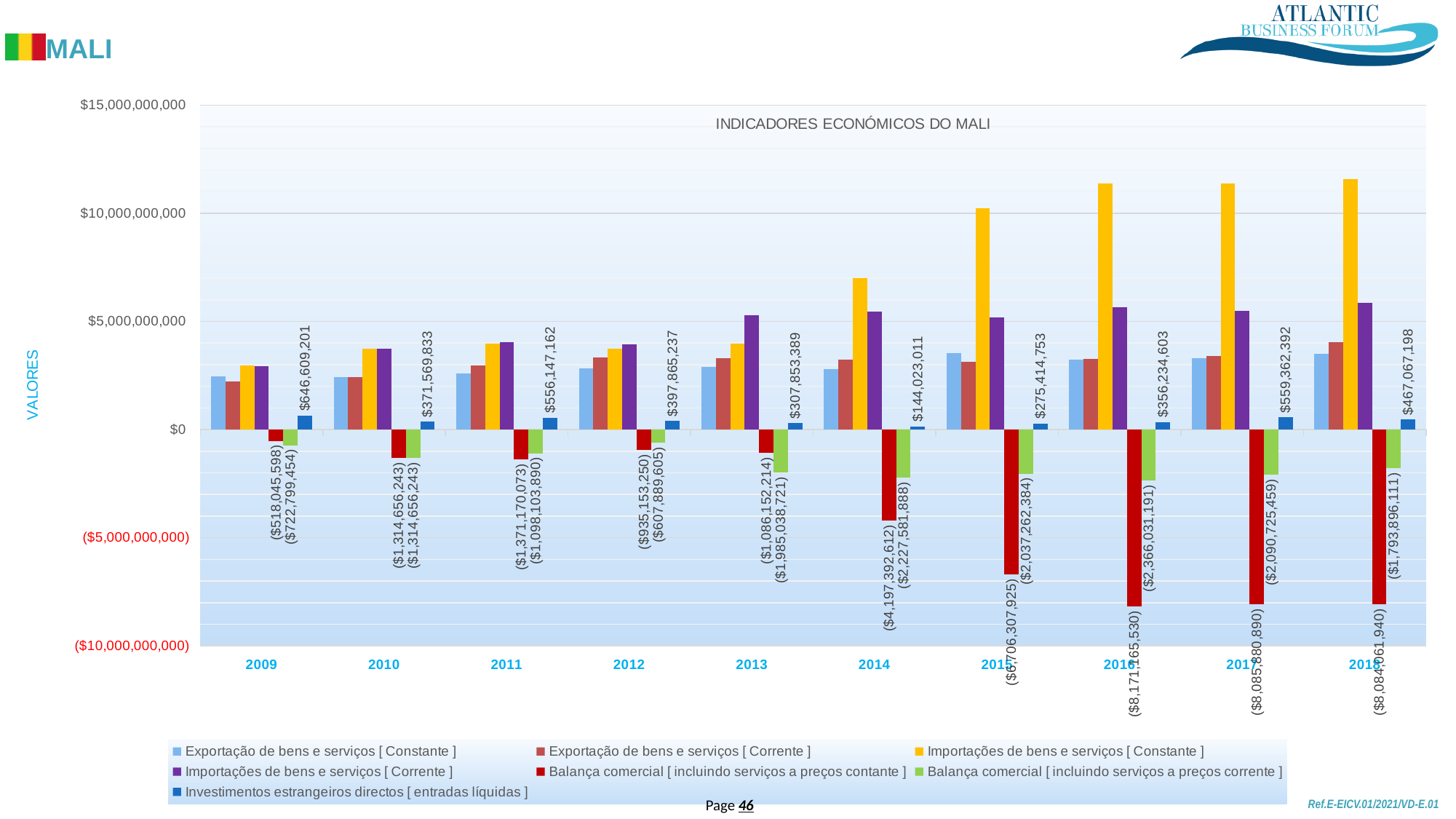
What is the value of Balança comercial [ incluindo serviços a preços corrente ] in 2013? ($1,985,038,721) In which year is Investimentos estrangeiros directos [ entradas líquidas ] lowest? 2014 Which year has the larger value for Importações de bens e serviços [ Constante ], 2013 or 2014? 2014 How many series does the legend list? 7 What is the title of the chart? INDICADORES ECONÓMICOS DO MALI What kind of chart is shown on the slide? bar chart How many years are shown on the x axis of the chart? 10 What is the difference between Investimentos estrangeiros directos in 2009 and in 2010? $275,039,368 What is the value of Investimentos estrangeiros directos [ entradas líquidas ] in 2014? $144,023,011 What is the value of Investimentos estrangeiros directos [ entradas líquidas ] in 2009? $646,609,201 Is the value of Importações de bens e serviços [ Constante ] in 2018 greater or less than $10,000,000,000? greater In which year is Investimentos estrangeiros directos [ entradas líquidas ] highest? 2009